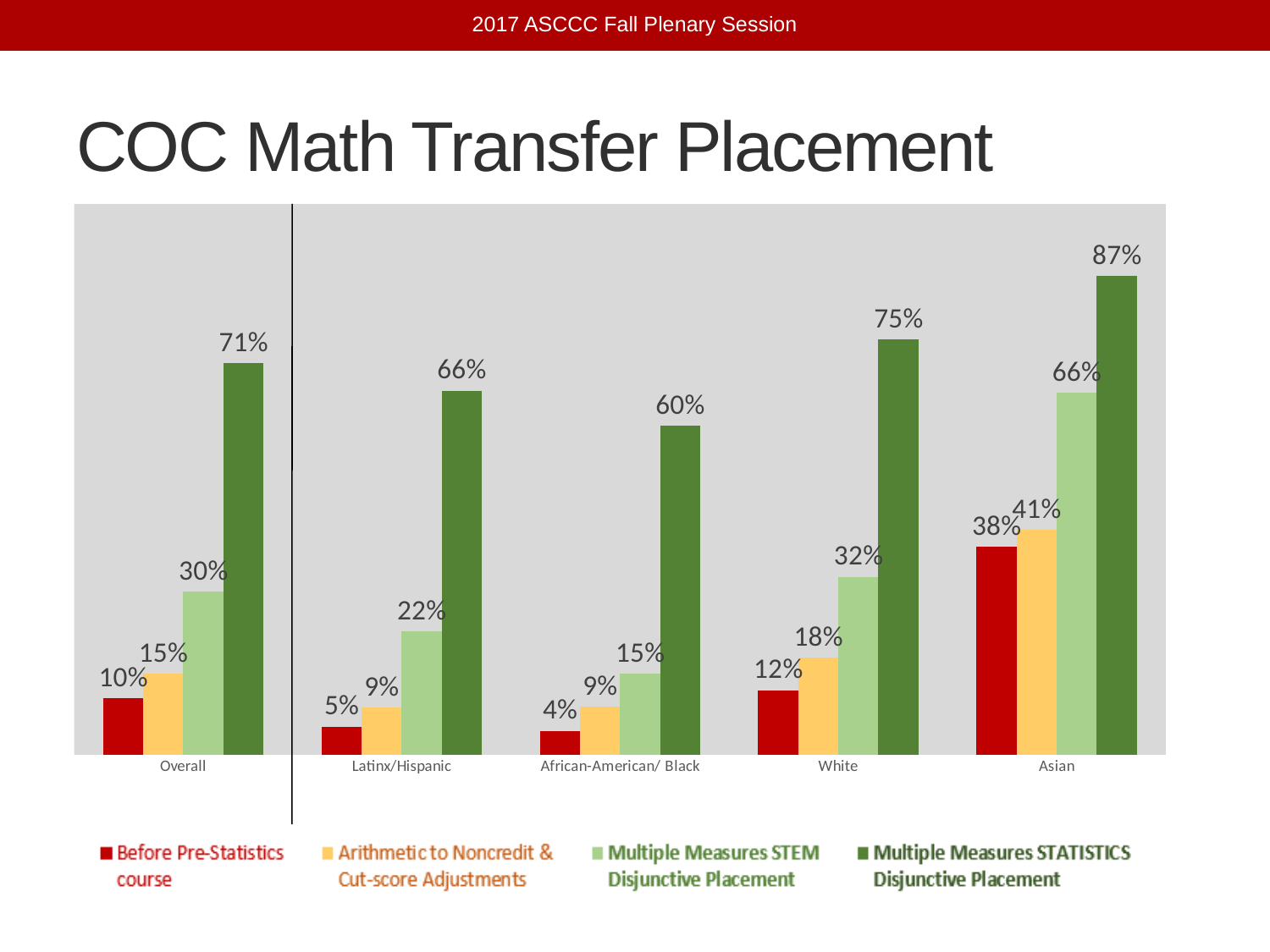
What is the Arithmetic to Noncredit & Cut-score Adjustments value for White? 18% What is the Multiple Measures STATISTICS Disjunctive Placement value for Asian? 87% What is the title of the slide containing the chart? COC Math Transfer Placement Which is larger for White: the Multiple Measures STEM Disjunctive Placement value or the Arithmetic to Noncredit & Cut-score Adjustments value? Multiple Measures STEM Disjunctive Placement What is the difference between the Multiple Measures STATISTICS Disjunctive Placement value and the Before Pre-Statistics course value for Overall? 61% What kind of chart is shown on the slide? Bar chart What is the Multiple Measures STEM Disjunctive Placement value for Latinx/Hispanic? 22% How many series does the legend list? 4 How many categories are shown on the x axis? 5 Which category has the highest Multiple Measures STATISTICS Disjunctive Placement value? Asian Which category has the lowest Before Pre-Statistics course value? African-American/ Black What is the Before Pre-Statistics course value for Overall? 10%